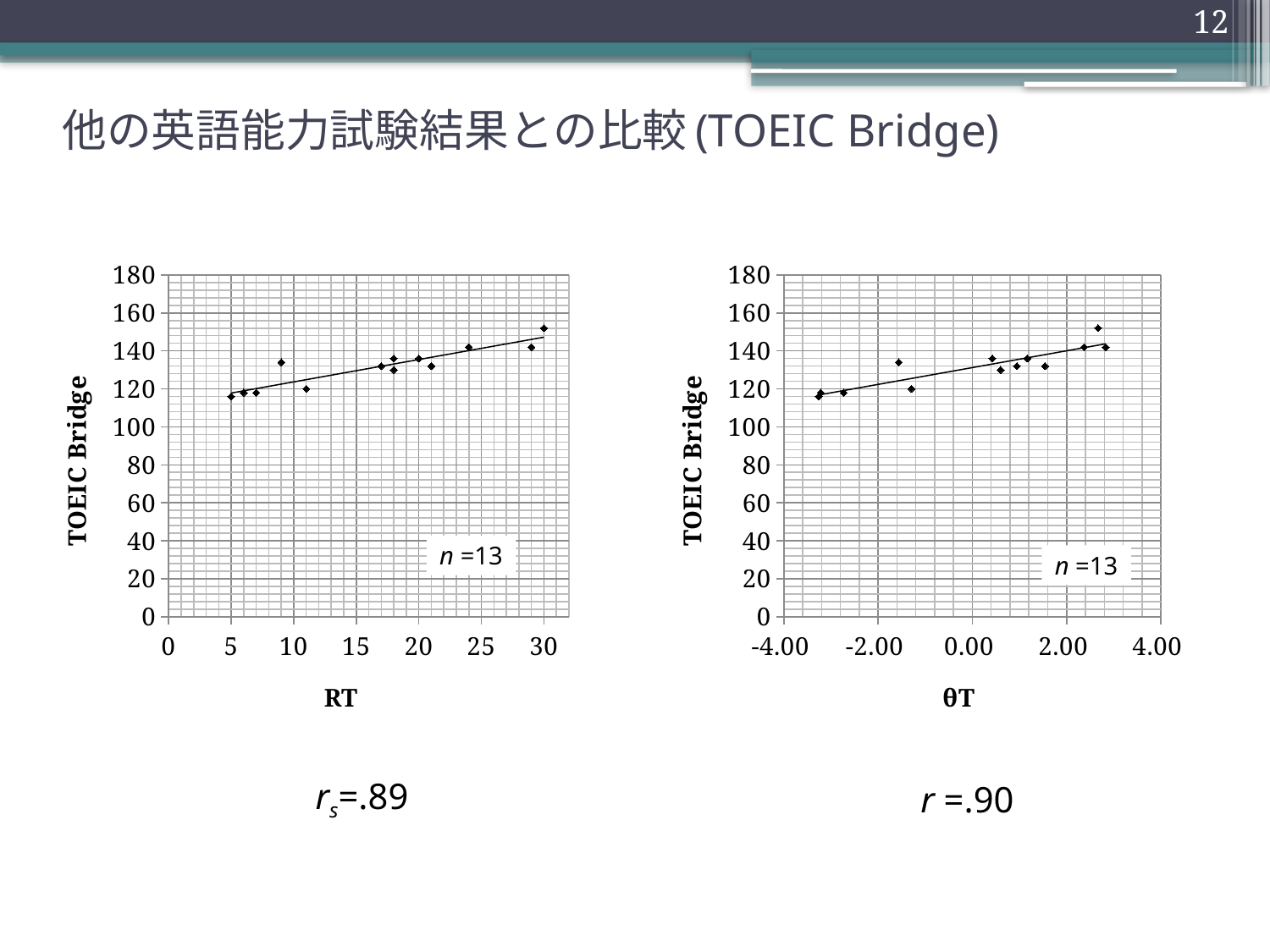
What is the label of the y axis on the left chart? TOEIC Bridge What kind of chart is the left chart with x axis RT? scatter chart In the right chart (x axis θT), do the TOEIC Bridge values generally rise or fall as θT increases? rise In the left chart (x axis RT), how many data points are plotted according to the n annotation? 13 In the left chart (x axis RT), do the TOEIC Bridge values generally rise or fall as RT increases? rise In the left chart (x axis RT), is the TOEIC Bridge value for the point at RT = 5 greater or less than 140? less What is the label of the x axis on the right chart? θT What kind of chart is the right chart with x axis θT? scatter chart In the right chart (x axis θT), is the highest plotted TOEIC Bridge value greater or less than 140? greater In the right chart (x axis θT), is the TOEIC Bridge value for the point at about θT = -3.00 greater or less than 140? less In the right chart (x axis θT), how many data points are plotted according to the n annotation? 13